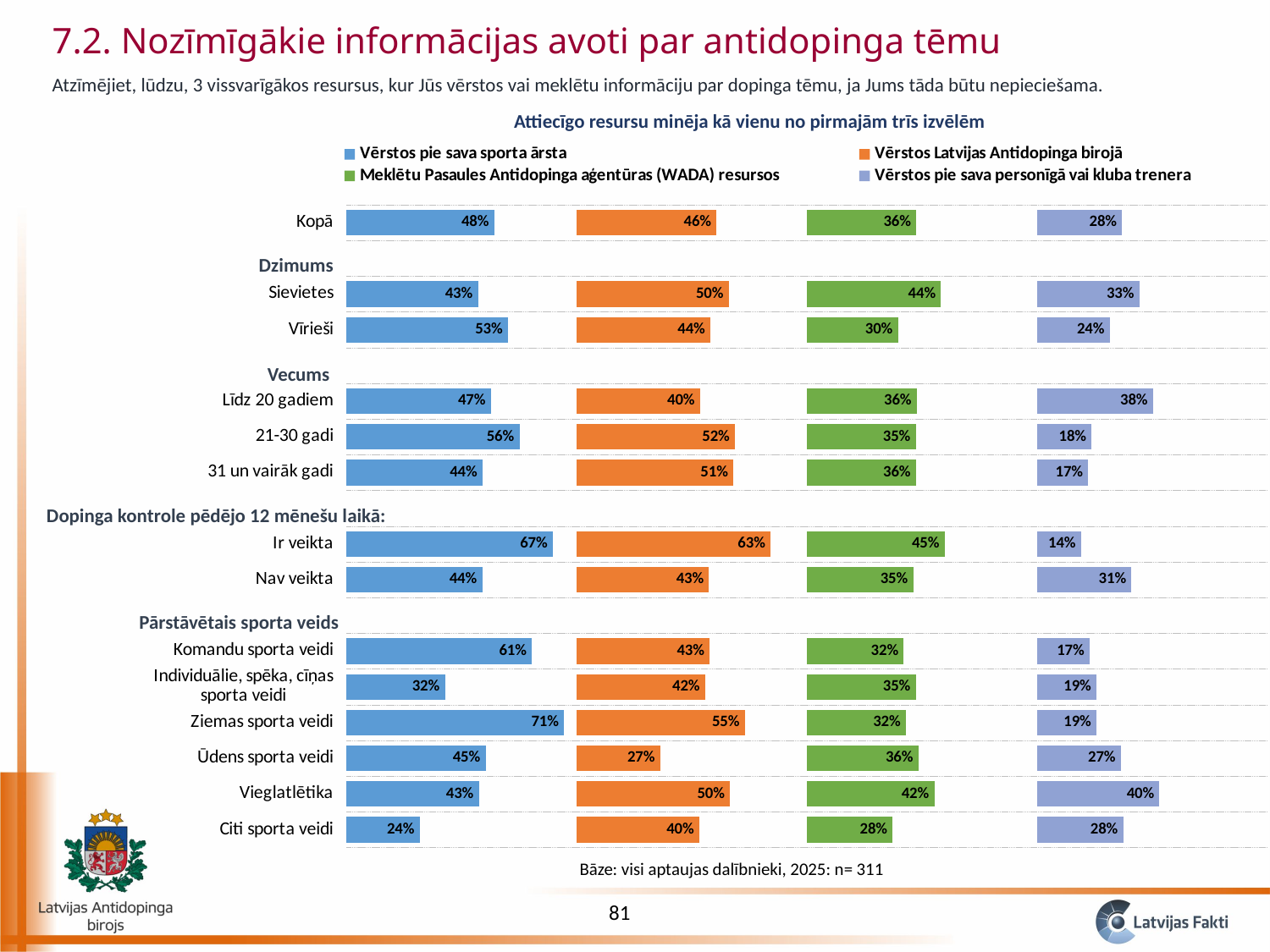
How many categories (rows) are plotted in the chart? 14 Which is larger for "Sievietes": "Vērstos pie sava sporta ārsta" or "Vērstos Latvijas Antidopinga birojā"? Vērstos Latvijas Antidopinga birojā What is the value for "Ziemas sporta veidi" in the "Vērstos Latvijas Antidopinga birojā" series? 55% Which category has the highest value in the "Vērstos pie sava sporta ārsta" series? Ziemas sporta veidi What is the value for "Citi sporta veidi" in the "Meklētu Pasaules Antidopinga aģentūras (WADA) resursos" series? 28% What is the value for "Vieglatlētika" in the "Vērstos pie sava personīgā vai kluba trenera" series? 40% Which colour represents the "Vērstos Latvijas Antidopinga birojā" series? Orange Which category has the lowest value in the "Vērstos pie sava personīgā vai kluba trenera" series? Ir veikta What is the value for "Kopā" in the "Vērstos pie sava sporta ārsta" series? 48% How many series does the legend list? 4 What is the difference between "Ir veikta" and "Nav veikta" in the "Vērstos pie sava sporta ārsta" series? 23 percentage points What kind of chart is shown on the slide? Bar chart